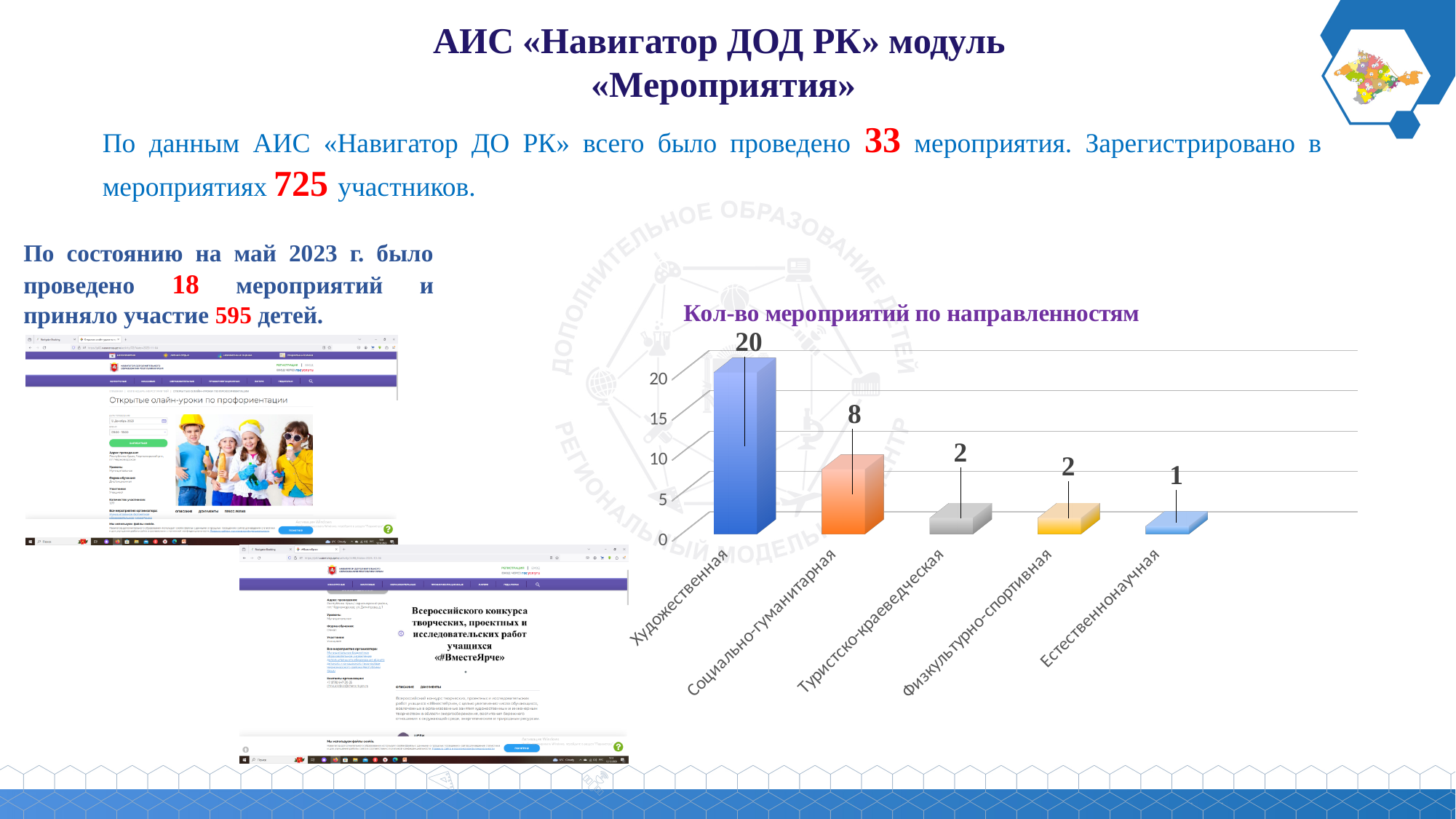
What is the value for Художественная in the chart? 20 Which category has the lowest value in the chart? Естественнонаучная What kind of chart is shown on the slide? bar chart What is the value for Социально-гуманитарная in the chart? 8 How many categories are shown in the chart? 5 What is the title of the chart? Кол-во мероприятий по направленностям Is the value for Художественная greater or less than 15? greater Which is larger, the value for Социально-гуманитарная or the value for Физкультурно-спортивная? Социально-гуманитарная Which category has the highest value in the chart? Художественная What is the difference between the values for Художественная and Социально-гуманитарная? 12 What is the value for Естественнонаучная in the chart? 1 What is the value for Туристско-краеведческая in the chart? 2